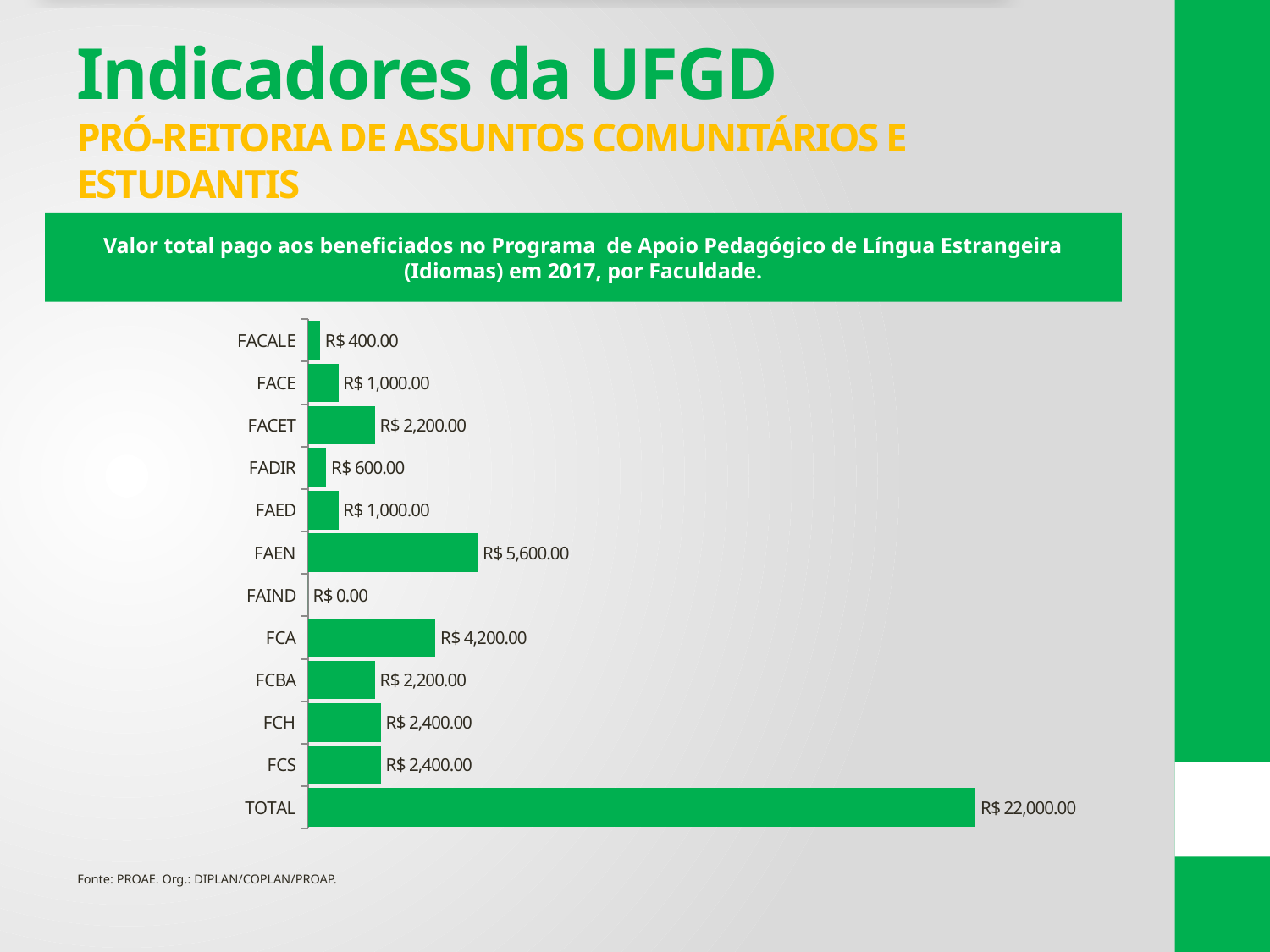
What is the value for FADIR? R$ 600.00 What is the value for FAEN? R$ 5,600.00 Which is larger, the value for FACET or the value for FCH? FCH How many categories are shown on the chart, including TOTAL? 12 What kind of chart is shown on the slide? Bar chart What is the difference between the values for FAEN and FCA? R$ 1,400.00 Excluding the TOTAL bar, which faculty has the highest value? FAEN What is the source cited below the chart? Fonte: PROAE. Org.: DIPLAN/COPLAN/PROAP. What is the difference between the values for FACE and FACALE? R$ 600.00 Which category has the lowest value? FAIND What is the value for FCA? R$ 4,200.00 What is the value shown for TOTAL? R$ 22,000.00